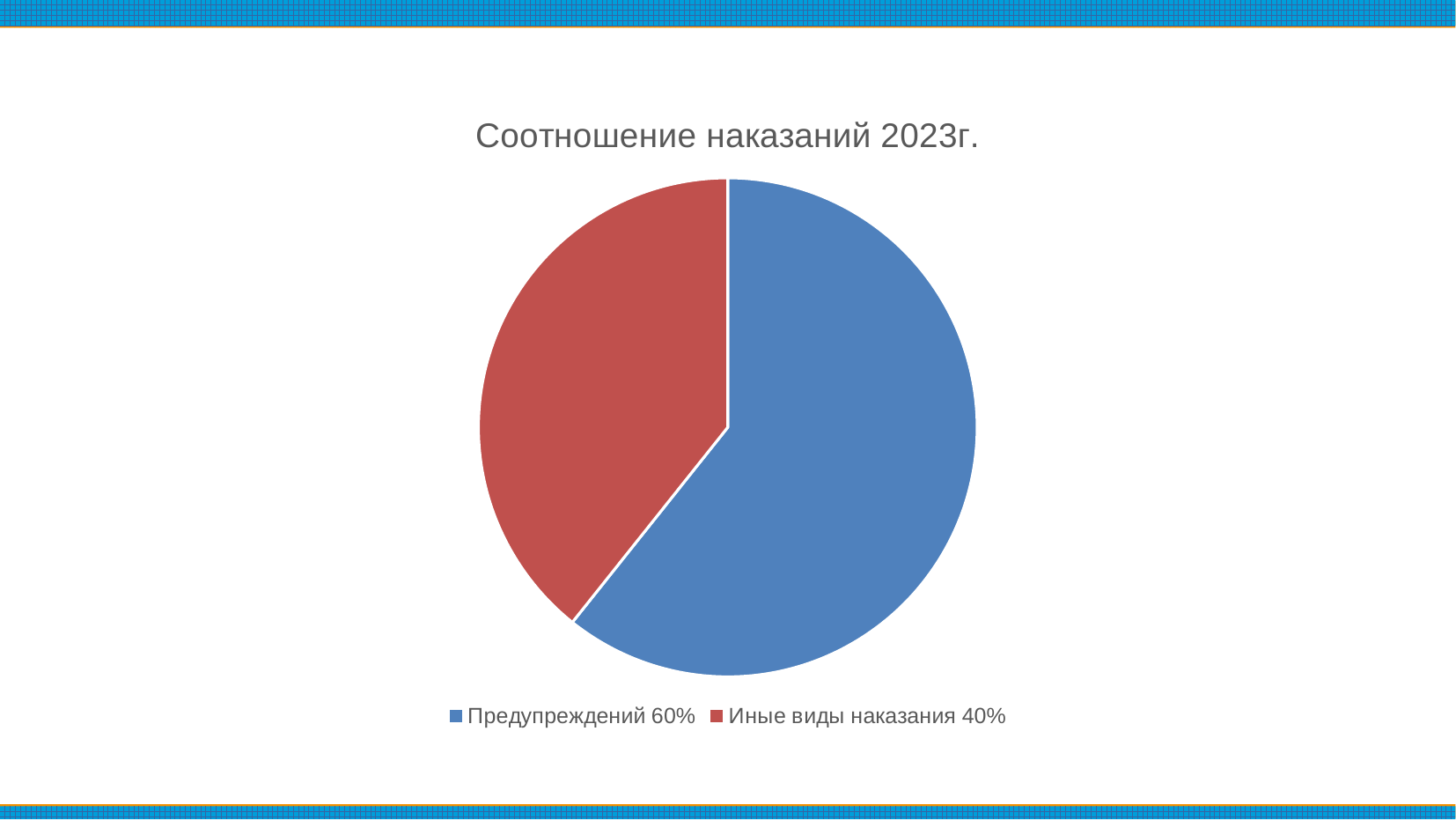
Which category has the smallest slice of the pie? Иные виды наказания Is the share for "Предупреждений" greater or less than 50%? greater What is the title of the chart? Соотношение наказаний 2023г. What share of the pie is labelled "Предупреждений"? 60% What colour is the slice for "Иные виды наказания"? red What type of chart is shown on the slide? pie chart Which is larger: the share for "Предупреждений" or the share for "Иные виды наказания"? Предупреждений How many entries does the legend list? 2 How many slices does the pie chart have? 2 What share of the pie is labelled "Иные виды наказания"? 40% Which category has the largest slice of the pie? Предупреждений What is the difference in percentage points between "Предупреждений" and "Иные виды наказания"? 20%